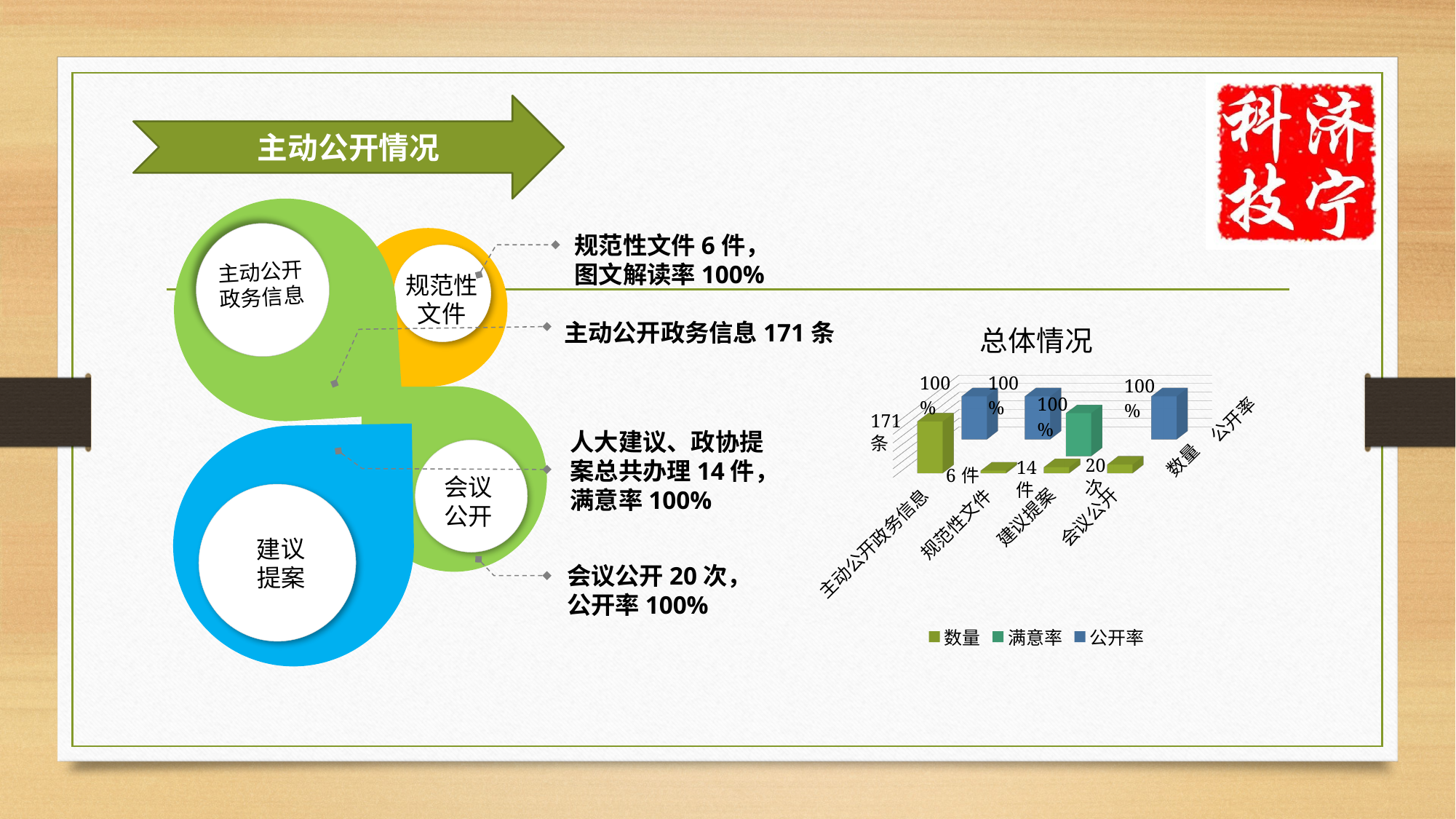
In the 总体情况 chart, what is the 数量 value for 主动公开政务信息? 171 条 How many series does the legend of the 总体情况 chart list? 3 In the 总体情况 chart, what is the 数量 value for 建议提案? 14 件 How many categories are shown on the x axis of the 总体情况 chart? 4 In the 总体情况 chart, which category has the highest 数量 value? 主动公开政务信息 In the 总体情况 chart, what is the 满意率 value for 建议提案? 100% In the 总体情况 chart, what is the 数量 value for 会议公开? 20 次 In the 总体情况 chart, which category has the lowest 数量 value? 规范性文件 In the 总体情况 chart, what is the 数量 value for 规范性文件? 6 件 What is the title of the chart on the slide? 总体情况 In the 总体情况 chart, what is the difference between the 数量 values for 建议提案 and 规范性文件? 8 件 What kind of chart is shown under the title 总体情况? bar chart